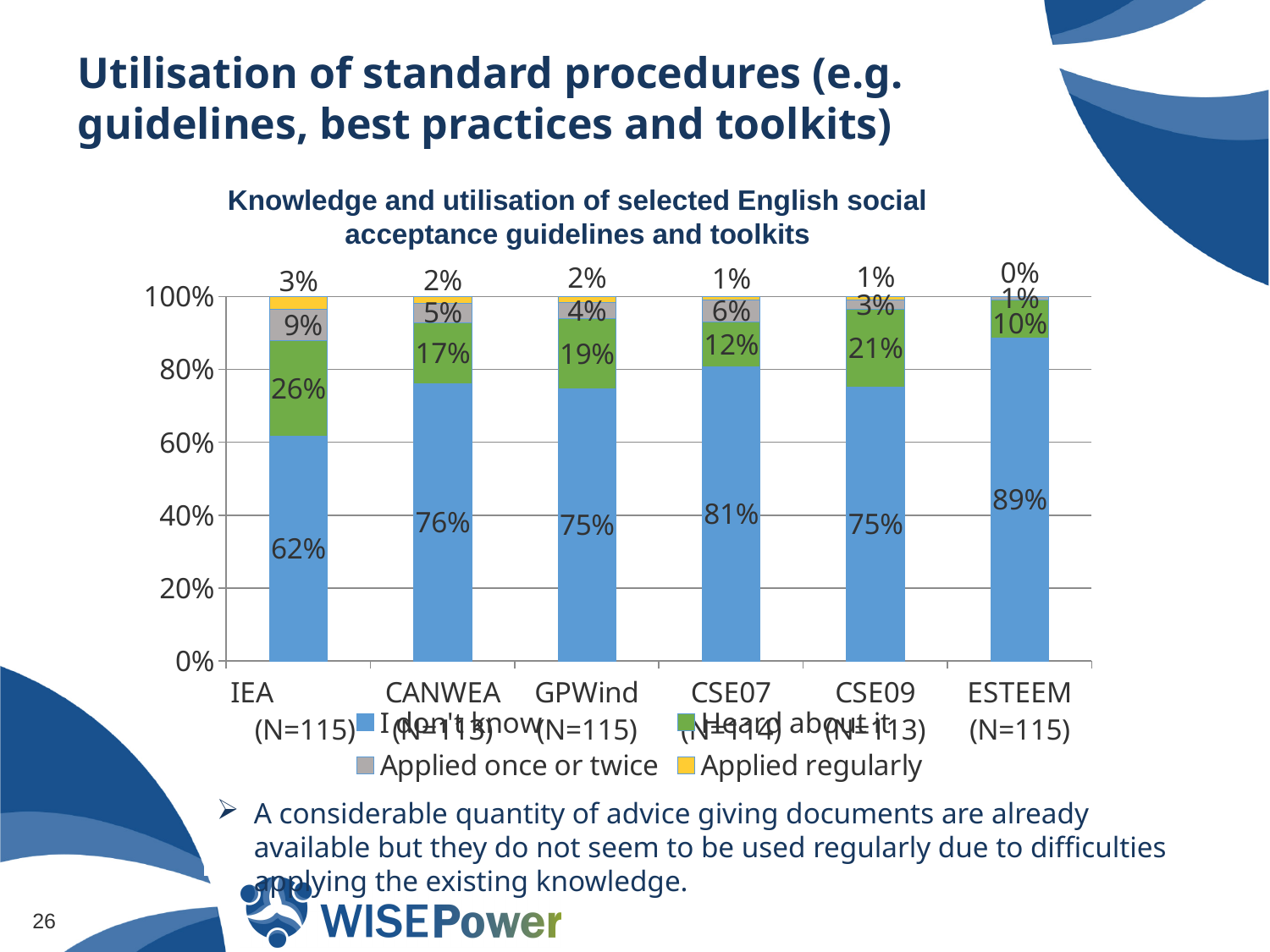
What type of chart is shown on the slide? Stacked bar chart What is the 'Applied regularly' value for ESTEEM? 0% Which category has the highest 'I don't know' value? ESTEEM How many categories (guidelines/toolkits) are shown on the x axis? 6 Which category has the lowest 'I don't know' value? IEA Which is larger, the 'Heard about it' value for GPWind or for CSE07? GPWind What is the title of the chart? Knowledge and utilisation of selected English social acceptance guidelines and toolkits What is the 'Applied once or twice' value for CSE07? 6% What is the 'Heard about it' value for CSE09? 21% What is the 'I don't know' value for IEA? 62% How many series does the legend list? 4 What is the difference between the 'I don't know' values for ESTEEM and IEA? 27%